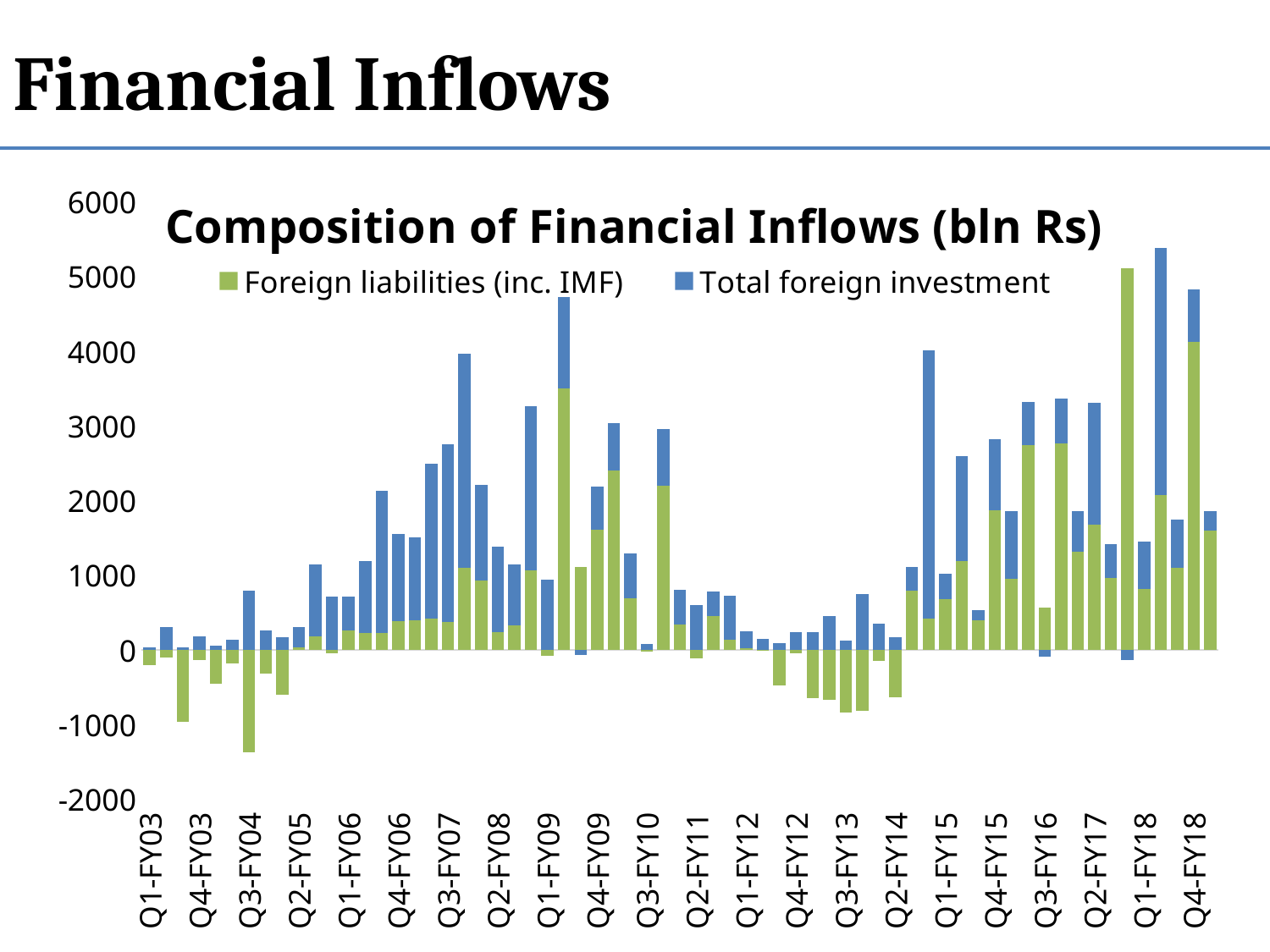
What kind of chart is shown on the slide? Stacked bar chart What are the two series named in the legend? Foreign liabilities (inc. IMF) and Total foreign investment Is the value for Total foreign investment in Q1-FY12 greater or less than 1000? less Is the value for Foreign liabilities (inc. IMF) in Q3-FY13 greater or less than 0? less Is the value for Foreign liabilities (inc. IMF) in Q4-FY18 greater or less than 1000? greater Which is larger, Total foreign investment in Q3-FY07 or in Q1-FY12? Q3-FY07 Which is larger, Foreign liabilities (inc. IMF) in Q4-FY18 or in Q3-FY04? Q4-FY18 What is the title of the chart? Composition of Financial Inflows (bln Rs) How many series does the chart legend list? 2